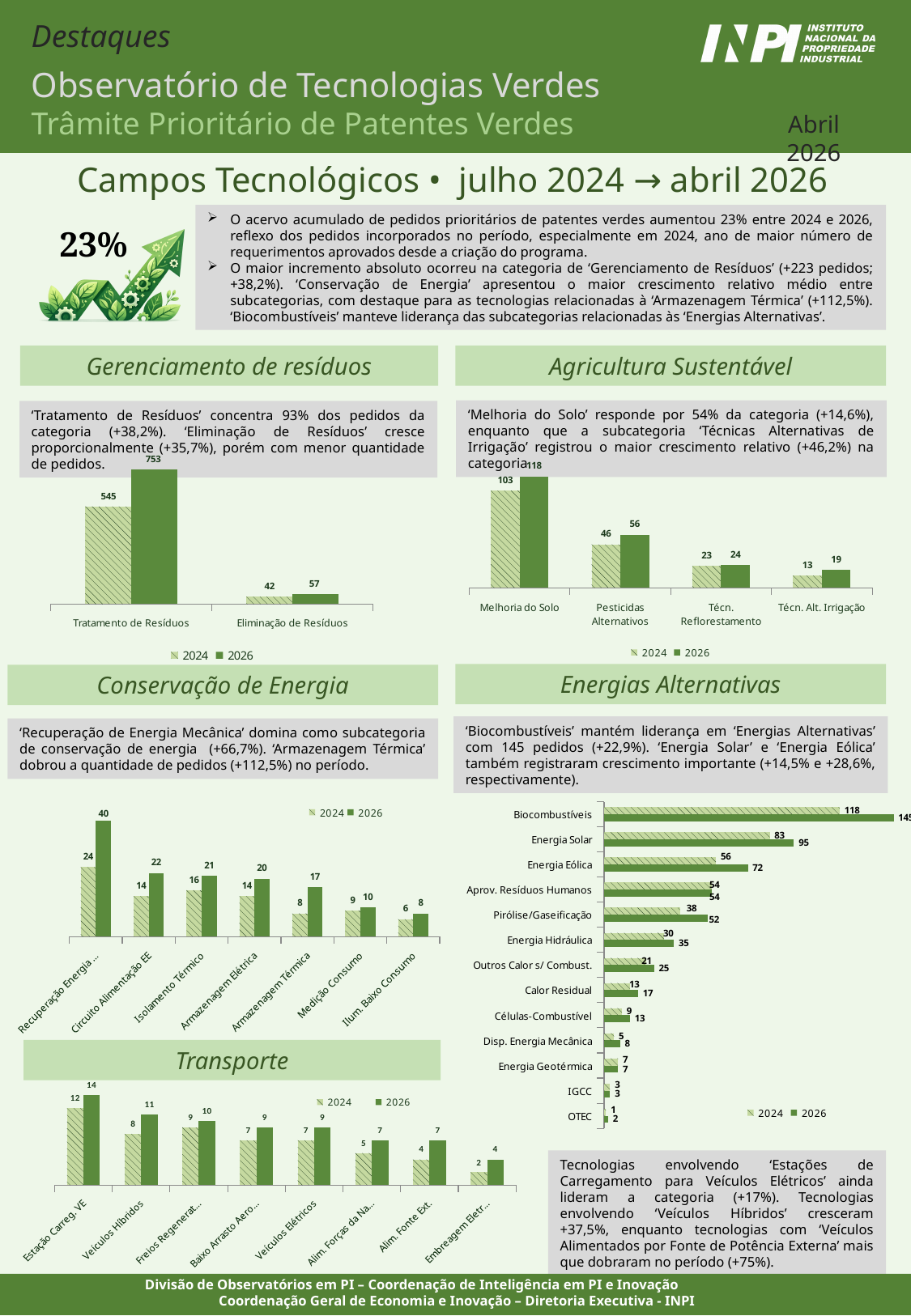
In the 'Conservação de Energia' chart, what is the 2026 value for Armazenagem Térmica? 17 In the 'Agricultura Sustentável' chart, what is the 2024 value for Pesticidas Alternativos? 46 In the 'Gerenciamento de resíduos' chart, what is the difference between the 2026 and 2024 values for Tratamento de Resíduos? 208 What type of chart is the 'Transporte' chart? bar chart In the 'Energias Alternativas' chart, is the 2026 value for Energia Solar larger or smaller than the 2026 value for Energia Eólica? larger How many categories are shown in the 'Agricultura Sustentável' chart? 4 In the 'Conservação de Energia' chart, which category has the highest 2026 value? Recuperação Energia ... In the 'Energias Alternativas' chart, what is the 2024 value for Energia Eólica? 56 In the 'Transporte' chart, what is the 2026 value for Veículos Híbridos? 11 In the 'Gerenciamento de resíduos' chart, what is the 2026 value for Tratamento de Resíduos? 753 In the 'Agricultura Sustentável' chart, which category has the lowest 2026 value? Técn. Alt. Irrigação How many series does the legend of the 'Energias Alternativas' chart list? 2